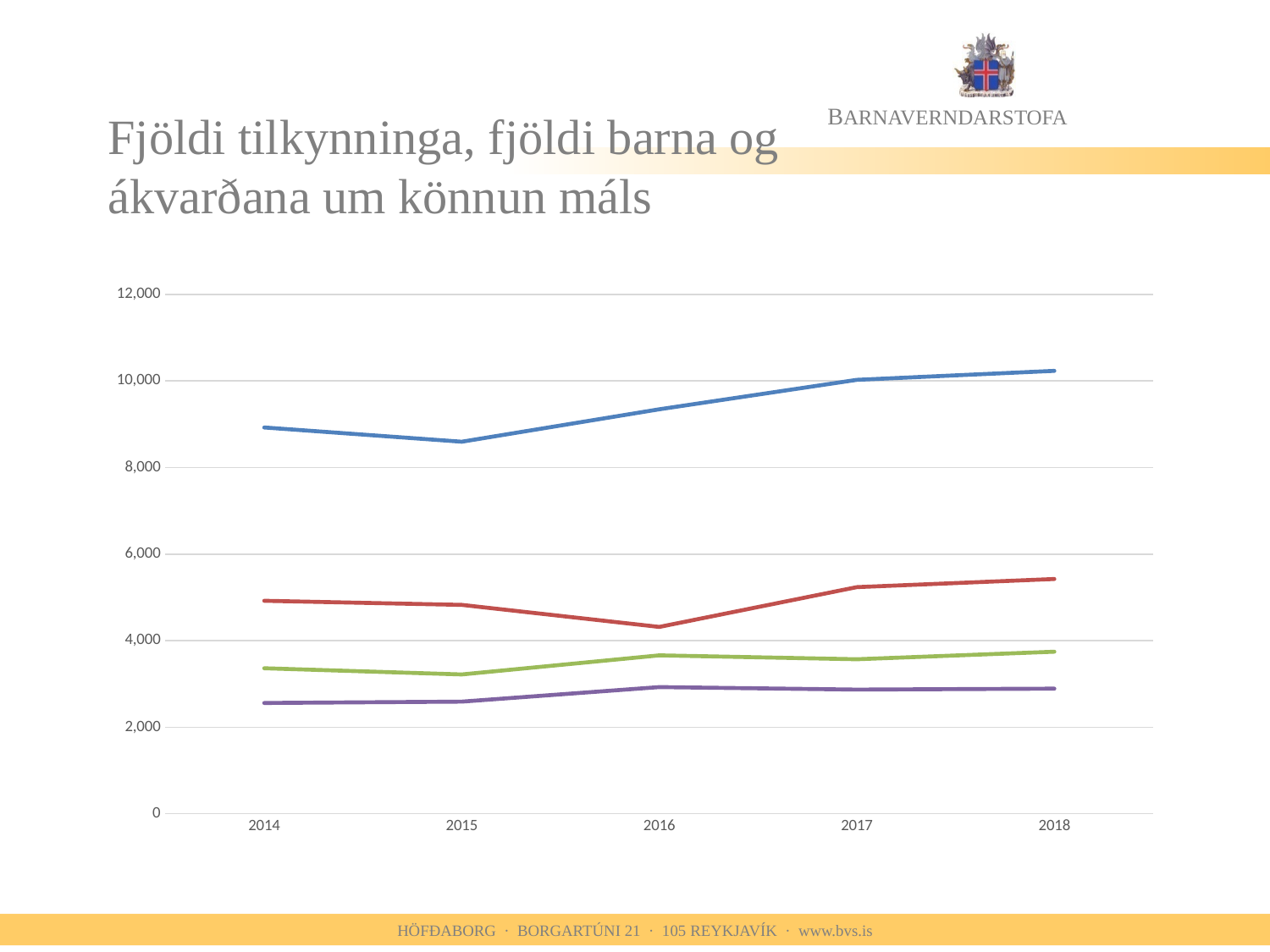
In which year does the red line reach its lowest value? 2016 Does the blue line rise or fall from 2015 to 2018? rise Is the value of the blue line in 2015 greater or less than 10,000? less How many years are shown on the x axis of the chart? 5 Is the value of the blue line in 2014 greater or less than 8,000? greater Is the value of the red line in 2016 greater or less than 4,000? greater What is the title of the slide containing the chart? Fjöldi tilkynninga, fjöldi barna og ákvarðana um könnun máls How many lines are plotted on the chart? 4 What kind of chart is shown on the slide? line chart In which year does the blue line reach its lowest value? 2015